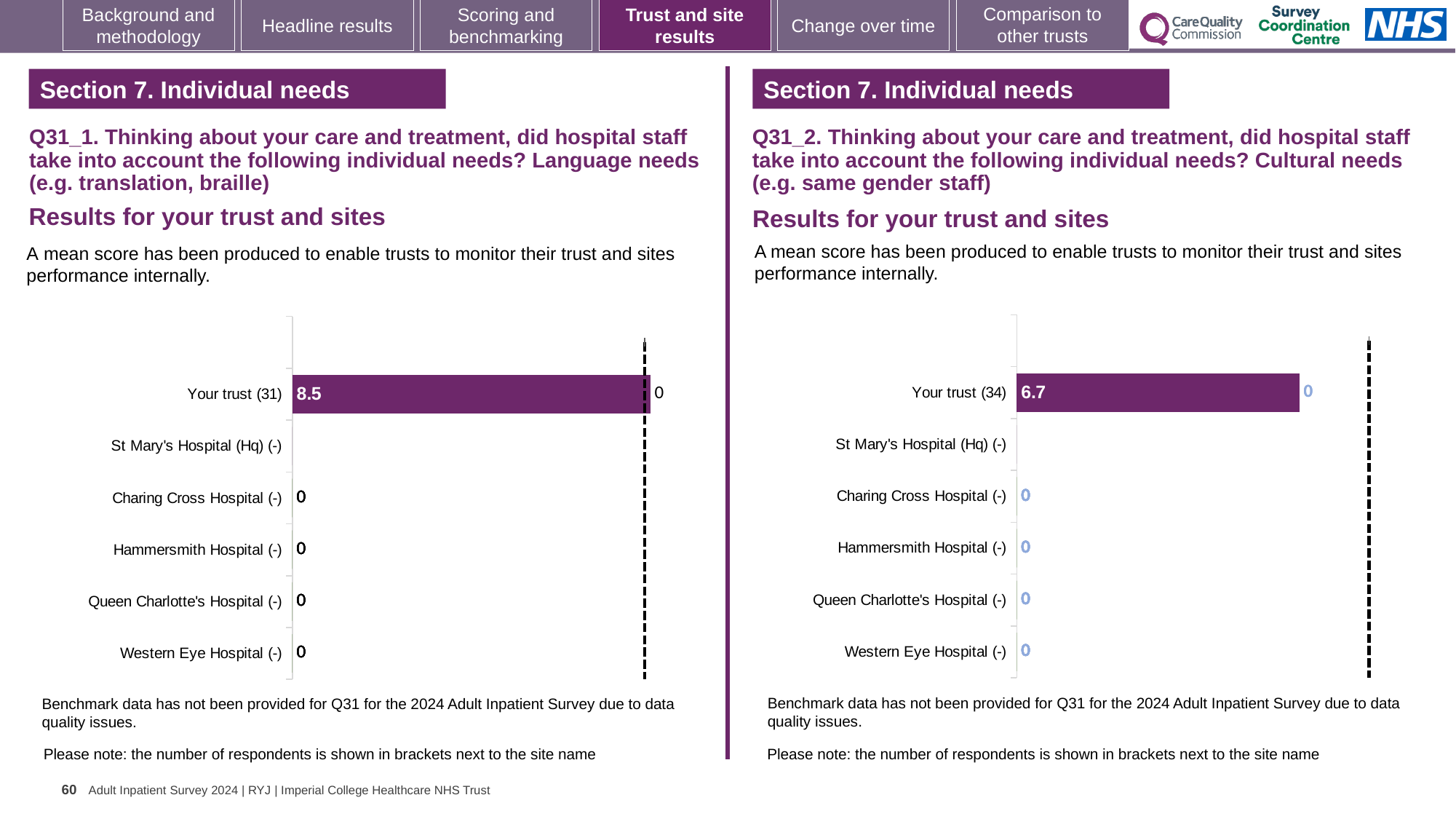
What type of chart is used on the left side of the slide (Q31_1)? Bar chart On the right chart (Q31_2), how many respondents are shown in brackets next to Your trust? 34 On the left chart (Q31_1), how many respondents are shown in brackets next to Your trust? 31 On the right chart (Q31_2), how many categories are listed on the vertical axis? 6 On the left chart (Q31_1), which category has the highest plotted value? Your trust (31) What is the difference between the Your trust score on the left chart (8.5) and the Your trust score on the right chart (6.7)? 1.8 On the right chart (Q31_2, Cultural needs), what is the mean score for Your trust? 6.7 On the left chart (Q31_1, Language needs), what is the mean score for Your trust? 8.5 Which chart shows a higher score for Your trust: the left chart (Language needs) or the right chart (Cultural needs)? Left chart (Language needs) On the left chart (Q31_1), how many categories are listed on the vertical axis? 6 On the right chart (Q31_2), which category has the highest plotted value? Your trust (34)